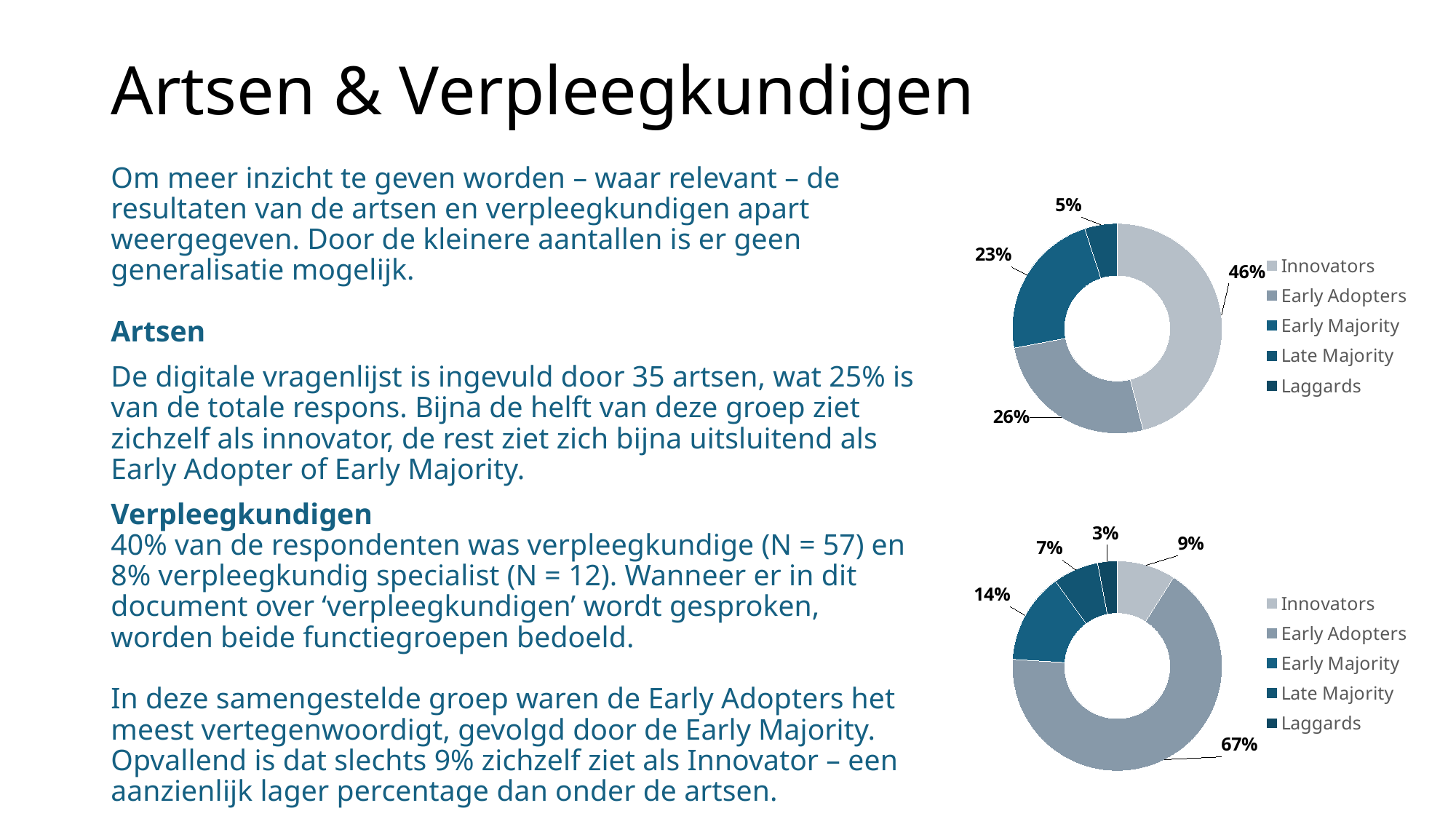
In the top chart, what percentage is shown for Innovators? 46% How many entries does the legend of the bottom chart list? 5 In the bottom chart, what percentage is shown for Laggards? 3% What kind of chart is the top chart? Doughnut chart In the top chart, which is larger: Early Adopters or Early Majority? Early Adopters In the top chart, which category has the largest share? Innovators In the bottom chart, which category has the smallest share? Laggards In the bottom chart, what is the difference in percentage points between Early Adopters and Early Majority? 53 In the bottom chart, what percentage is shown for Innovators? 9% In the top chart, what percentage is shown for Early Adopters? 26% In the bottom chart, which category has the largest share? Early Adopters In the bottom chart, what percentage is shown for Early Adopters? 67%